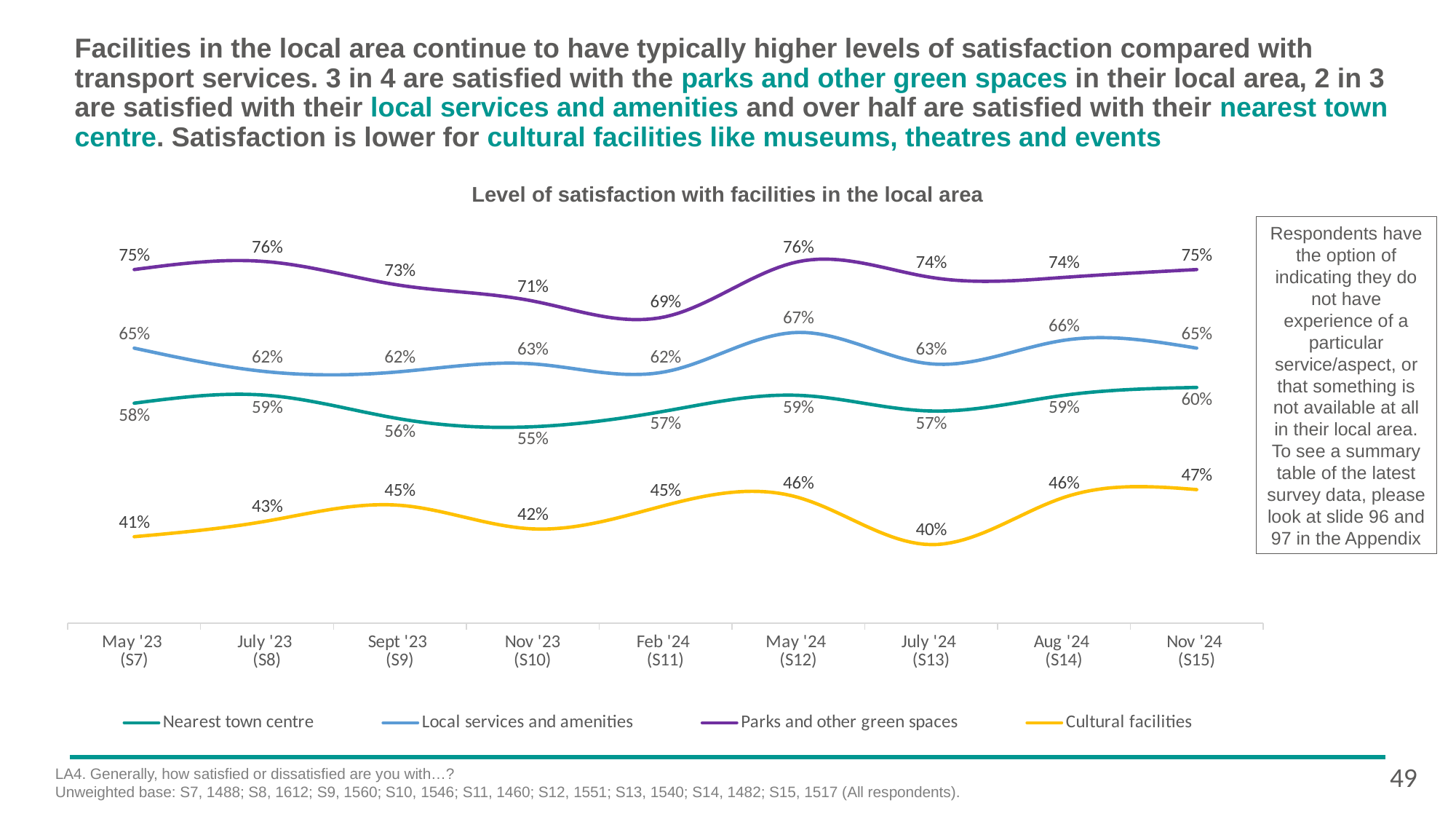
In which survey wave is the value for Parks and other green spaces lowest? Feb '24 (S11) What kind of chart is shown on the slide? Line chart Which is larger for Local services and amenities: the value in Nov '23 (S10) or in Feb '24 (S11)? Nov '23 (S10) In which survey wave is the value for Nearest town centre lowest? Nov '23 (S10) How many series does the legend list? 4 What is the value for Cultural facilities in July '24 (S13)? 40% How many survey waves are shown on the x axis? 9 Does the value for Cultural facilities rise or fall from July '24 (S13) to Nov '24 (S15)? Rise What is the value for Nearest town centre in Nov '24 (S15)? 60% What is the value for Parks and other green spaces in May '24 (S12)? 76% In which survey wave is the value for Cultural facilities highest? Nov '24 (S15) What is the difference between Parks and other green spaces and Cultural facilities in May '23 (S7)? 34 percentage points